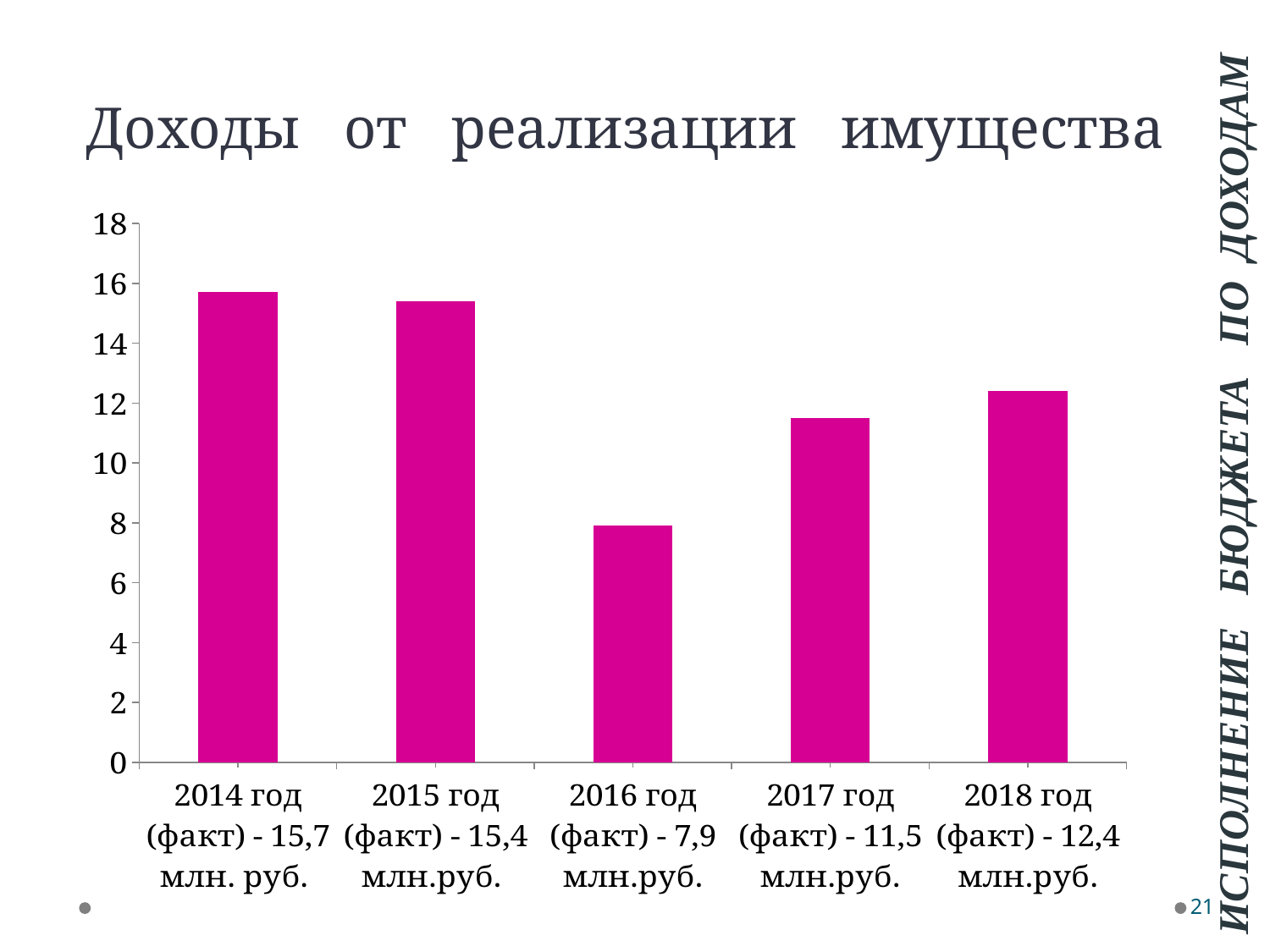
What is the value for 2014 год in the chart? 15,7 млн. руб. What is the value for 2018 год in the chart? 12,4 млн.руб. Which year has the lowest value in the chart? 2016 год Which is larger, the value for 2017 год or the value for 2016 год? 2017 год What is the difference between the values for 2018 год and 2017 год? 0,9 млн. руб. What is the title of the chart on the slide? Доходы от реализации имущества Which year has the highest value in the chart? 2014 год What is the difference between the values for 2014 год and 2016 год? 7,8 млн. руб. Is the value for 2015 год greater or less than 14? greater What is the value for 2016 год in the chart? 7,9 млн.руб. How many years (bars) are shown in the chart? 5 What kind of chart is shown on the slide? bar chart